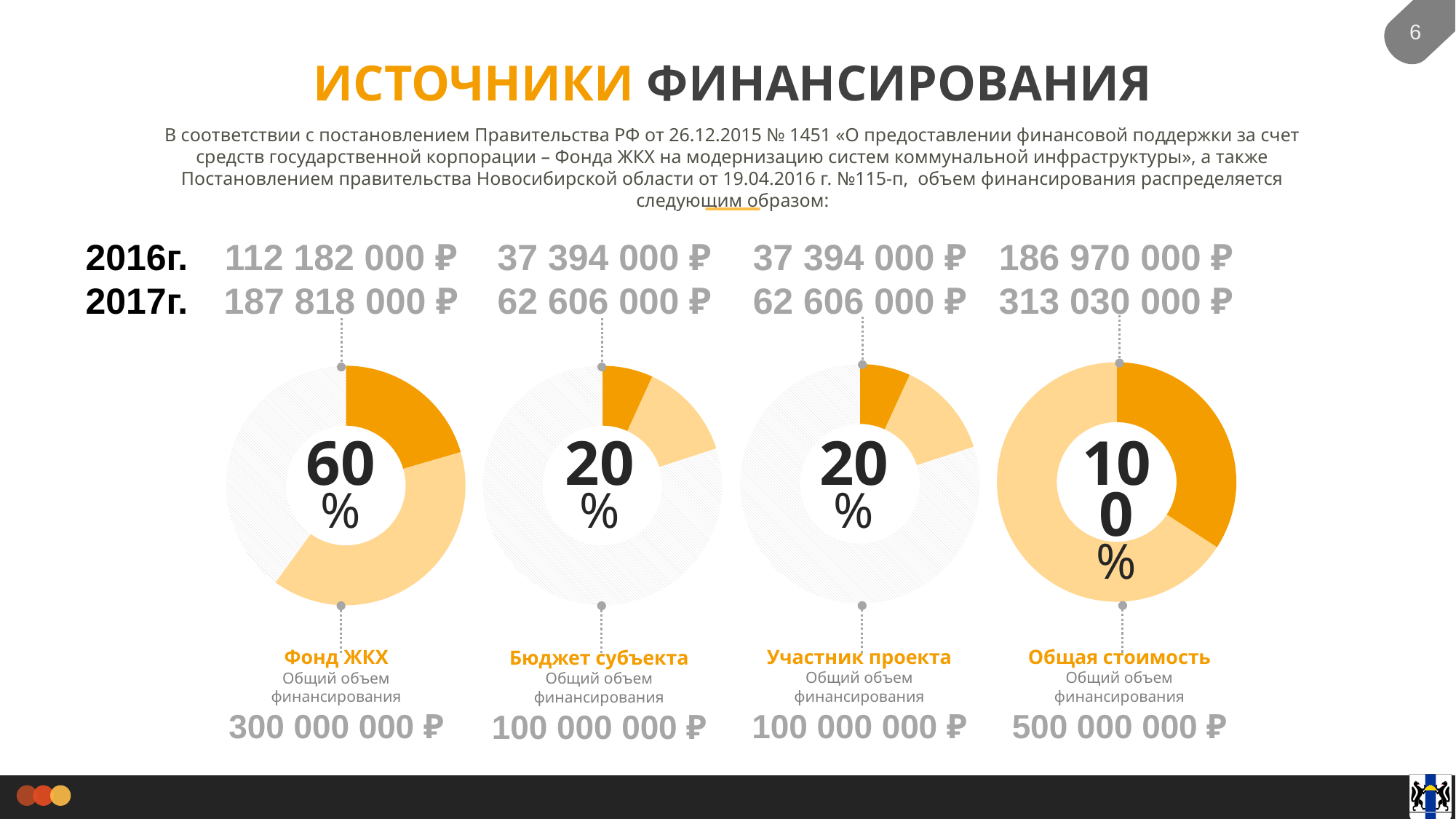
What percentage is shown in the centre of the Фонд ЖКХ donut chart? 60% What percentage is shown in the centre of the Общая стоимость donut chart? 100% Which funding source has the largest share among Фонд ЖКХ, Бюджет субъекта and Участник проекта? Фонд ЖКХ Is the Фонд ЖКХ share larger or smaller than the Участник проекта share? Larger What kind of chart is used for the Фонд ЖКХ figure on the slide? Donut (pie) chart What percentage is shown in the centre of the Бюджет субъекта donut chart? 20% How many donut charts are shown on the slide? 4 What is the difference between the Фонд ЖКХ share and the Бюджет субъекта share? 40% What is the total funding volume shown under the Участник проекта chart? 100 000 000 ₽ What is the total funding volume (Общий объем финансирования) shown under the Фонд ЖКХ chart? 300 000 000 ₽ What is the 2016 value shown above the Фонд ЖКХ chart? 112 182 000 ₽ What is the 2017 value shown above the Общая стоимость chart? 313 030 000 ₽